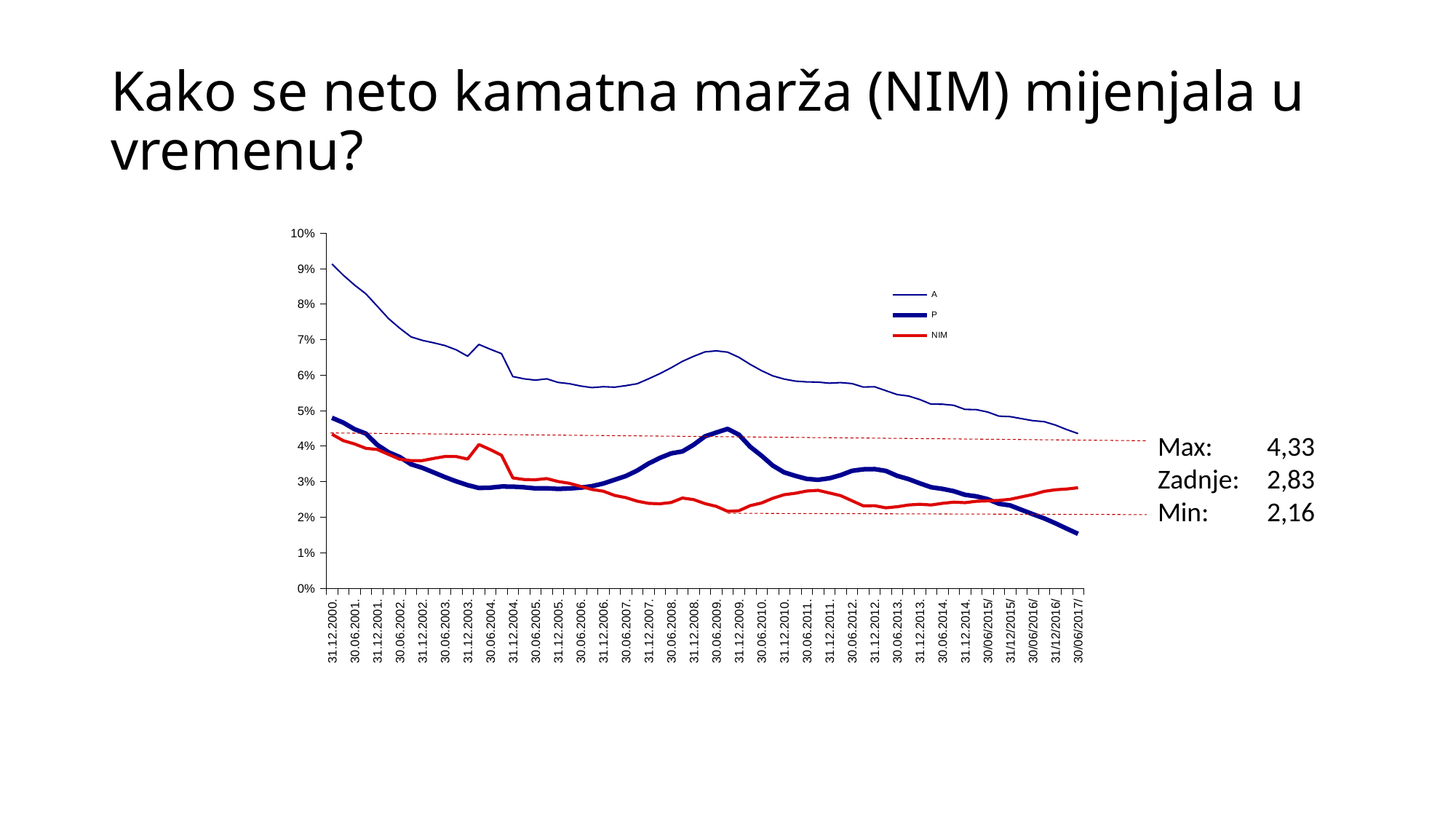
Which series has the higher value at 31.12.2000., A or P? A Is the value of series A at 30/06/2017/ greater or less than 5%? less What is the difference between the Max and Min values of NIM noted on the slide? 2,17 Is the value of series A at 31.12.2000. greater or less than 8%? greater How many series does the chart legend list? 3 Is the value of series P at 30/06/2017/ greater or less than 2%? less Does series A generally rise or fall from 31.12.2000. to 30/06/2017/? fall What is the last (Zadnje) value of NIM noted on the slide? 2,83 What is the maximum (Max) value of NIM noted on the slide? 4,33 What kind of chart is shown on the slide? line chart What are the names of the series listed in the chart legend? A, P, NIM What is the minimum (Min) value of NIM noted on the slide? 2,16